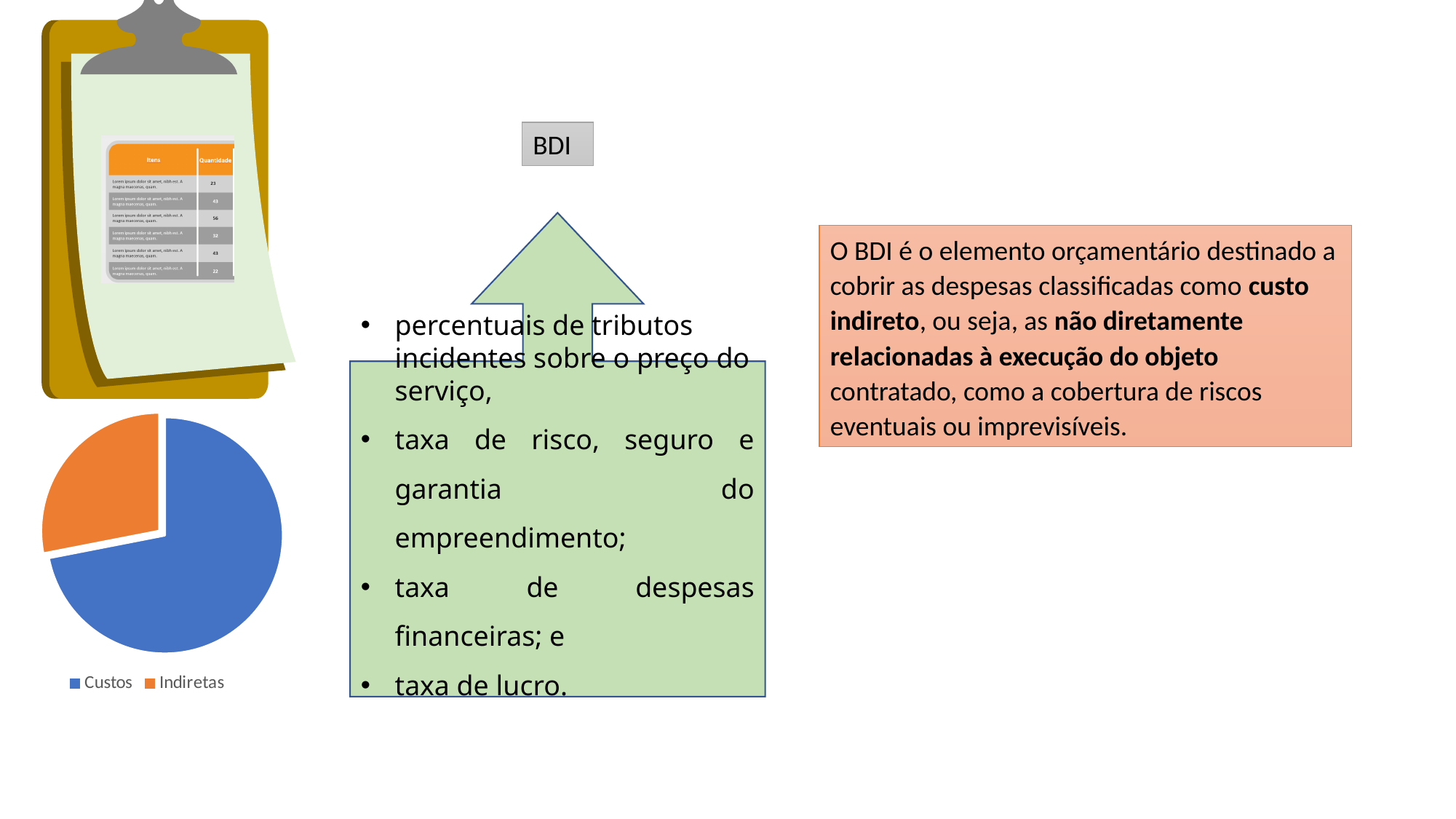
Which category has the largest slice in the pie chart? Custos Which category has the smallest slice in the pie chart? Indiretas How many entries does the legend of the pie chart list? 2 How many slices does the pie chart have? 2 What colour is the Custos slice in the pie chart? blue In the pie chart, which slice is larger, Custos or Indiretas? Custos What kind of chart is shown at the bottom left of the slide? pie chart What are the two legend entries of the pie chart? Custos and Indiretas